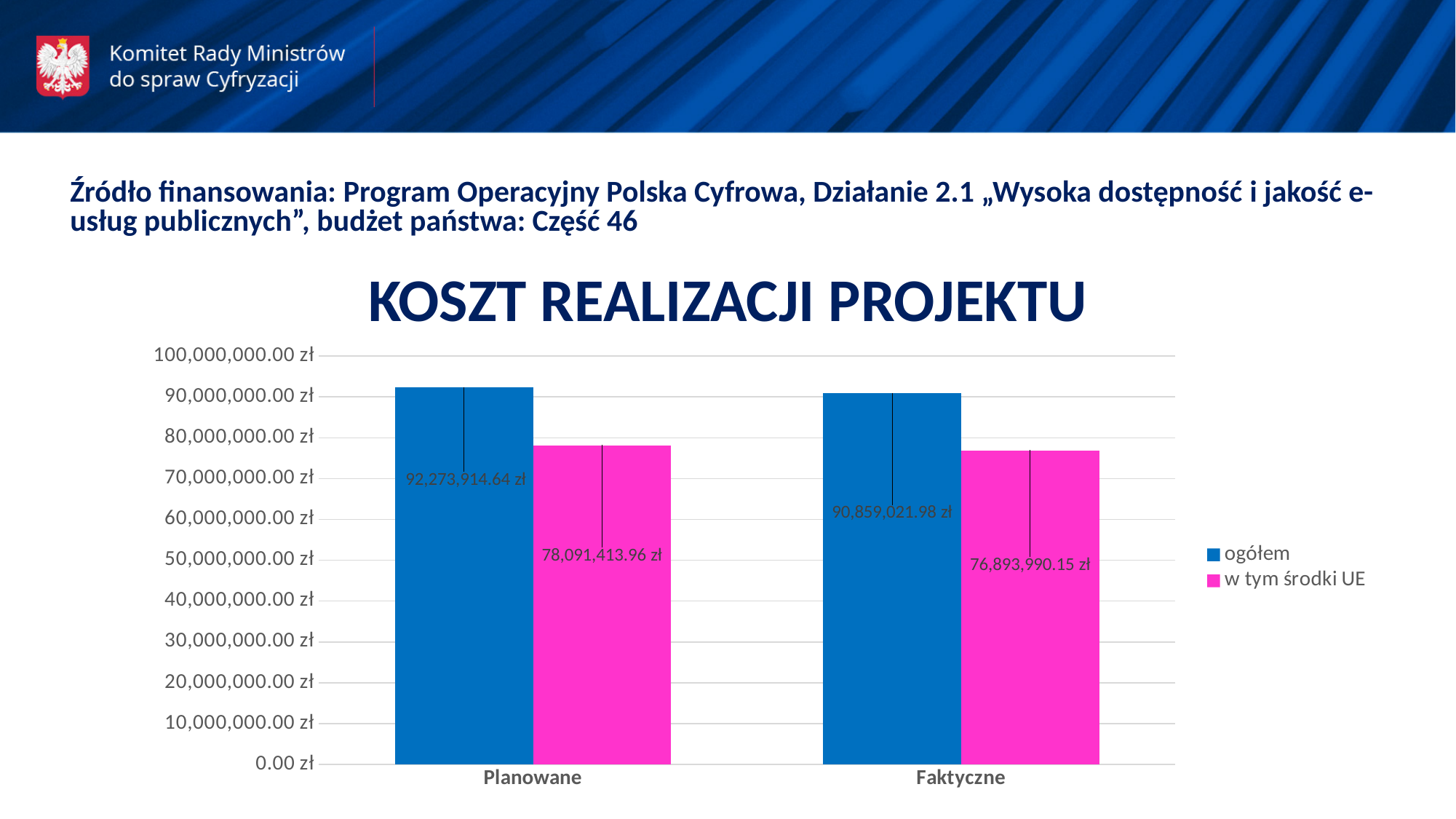
What is the value of the ogółem bar for Planowane? 92,273,914.64 zł Which bar on the chart has the lowest value? w tym środki UE for Faktyczne What is the value of the w tym środki UE bar for Planowane? 78,091,413.96 zł What is the value of the w tym środki UE bar for Faktyczne? 76,893,990.15 zł Which is larger: the w tym środki UE value for Planowane or for Faktyczne? Planowane How many series does the legend list? 2 Which bar on the chart has the highest value? ogółem for Planowane What is the value of the ogółem bar for Faktyczne? 90,859,021.98 zł What is the difference between the ogółem and w tym środki UE values for Planowane? 14,182,500.68 zł What is the title of the chart? KOSZT REALIZACJI PROJEKTU What is the difference between the ogółem values for Planowane and Faktyczne? 1,414,892.66 zł How many categories are shown on the x axis? 2